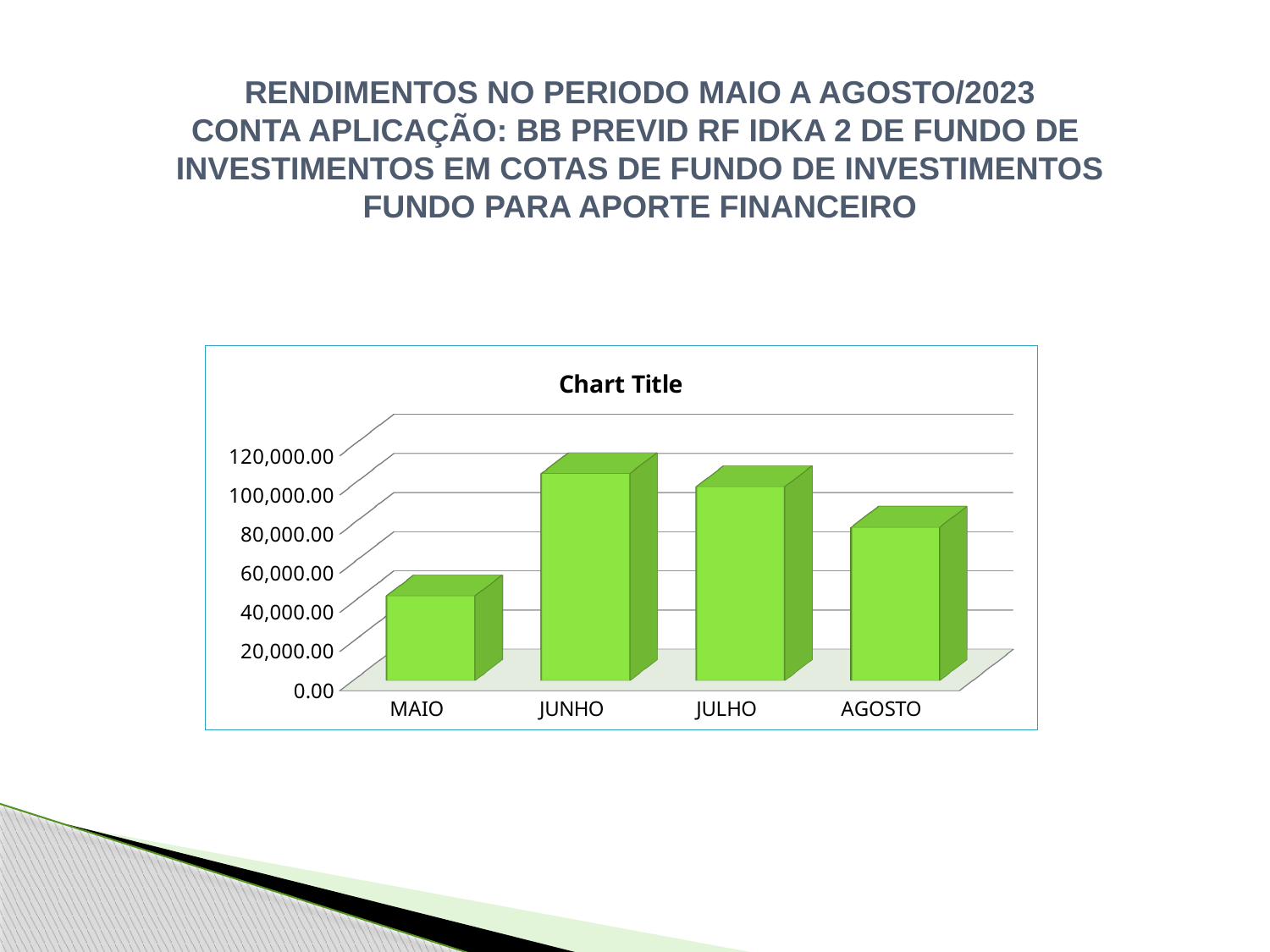
Which category has the lowest value in the chart? MAIO Is the value for JUNHO greater or less than 100,000.00? greater Which is larger, the value for JUNHO or the value for MAIO? JUNHO What kind of chart is shown on the slide? bar chart Which is larger, the value for JULHO or the value for AGOSTO? JULHO What title is printed above the chart's plot area? Chart Title Which category has the highest value in the chart? JUNHO Do the values rise or fall from JUNHO to AGOSTO? fall Is the value for AGOSTO greater or less than 100,000.00? less How many categories are shown on the x axis of the chart? 4 Is the value for MAIO greater or less than 60,000.00? less